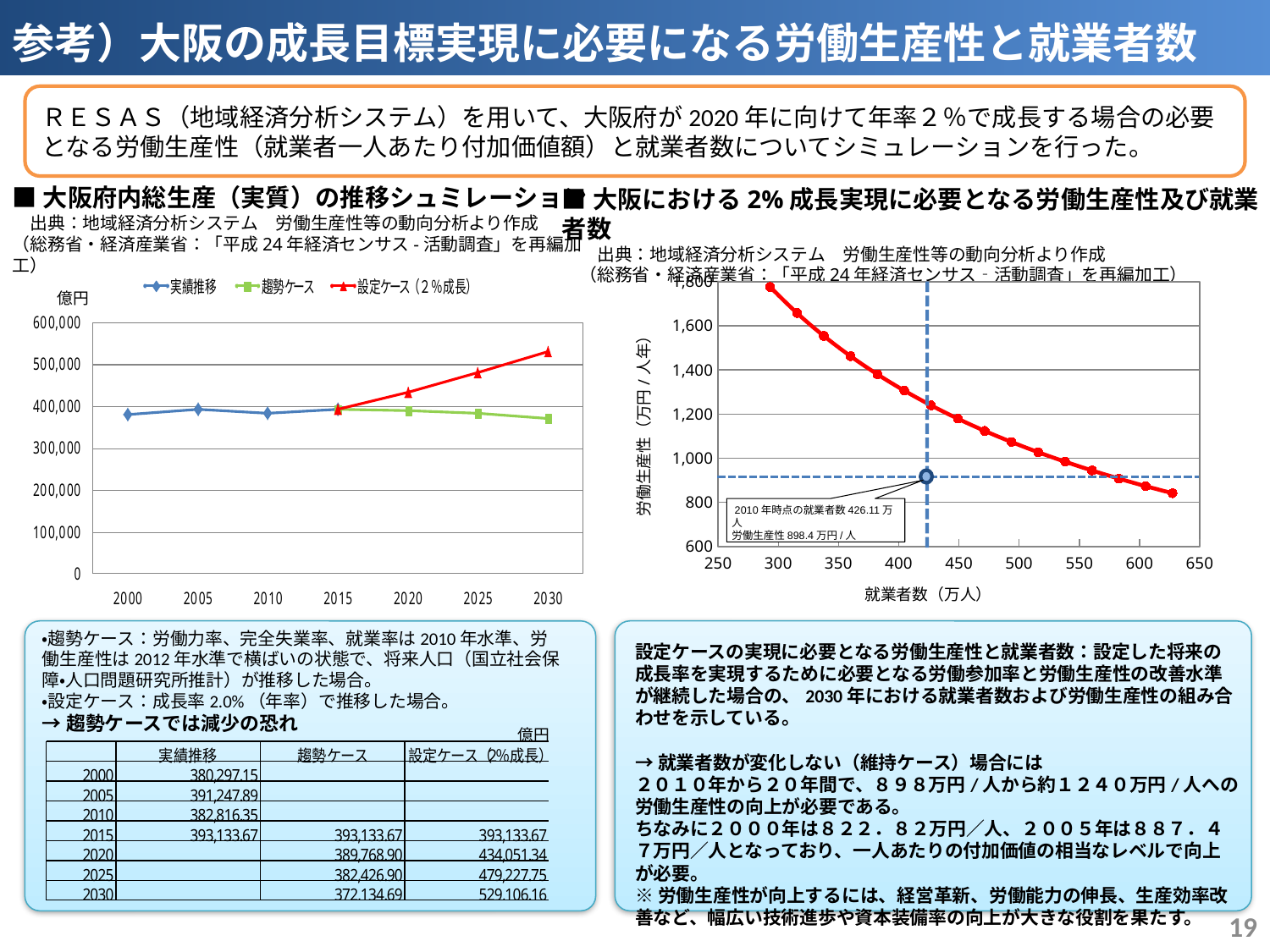
In the right chart, what is the 2010 就業者数 given in the annotation? 426.11万人 How many series does the legend of the left chart list? 3 In the left chart, what is the difference between 設定ケース（2%成長） and 趨勢ケース in 2030? 156,971.47 In the left chart, is the 2030 value of 設定ケース（2%成長） greater or less than 500,000? greater In the left chart, what is the value of 設定ケース（2%成長） in 2030, as printed in the table below it? 529,106.16 In the left chart, does 趨勢ケース rise or fall from 2015 to 2030? fall In the right chart, what is the 2010 労働生産性 given in the annotation? 898.4万円/人 In the right chart, does 労働生産性 rise or fall as 就業者数 increases along the x axis? fall In the left chart, which series is higher in 2025: 設定ケース（2%成長） or 趨勢ケース? 設定ケース（2%成長） What kind of chart is the left chart, 大阪府内総生産（実質）の推移シミュレーション? Line chart In the left chart, what is the value of 趨勢ケース in 2030, as printed in the table below it? 372,134.69 How many years are shown on the x axis of the left chart? 7